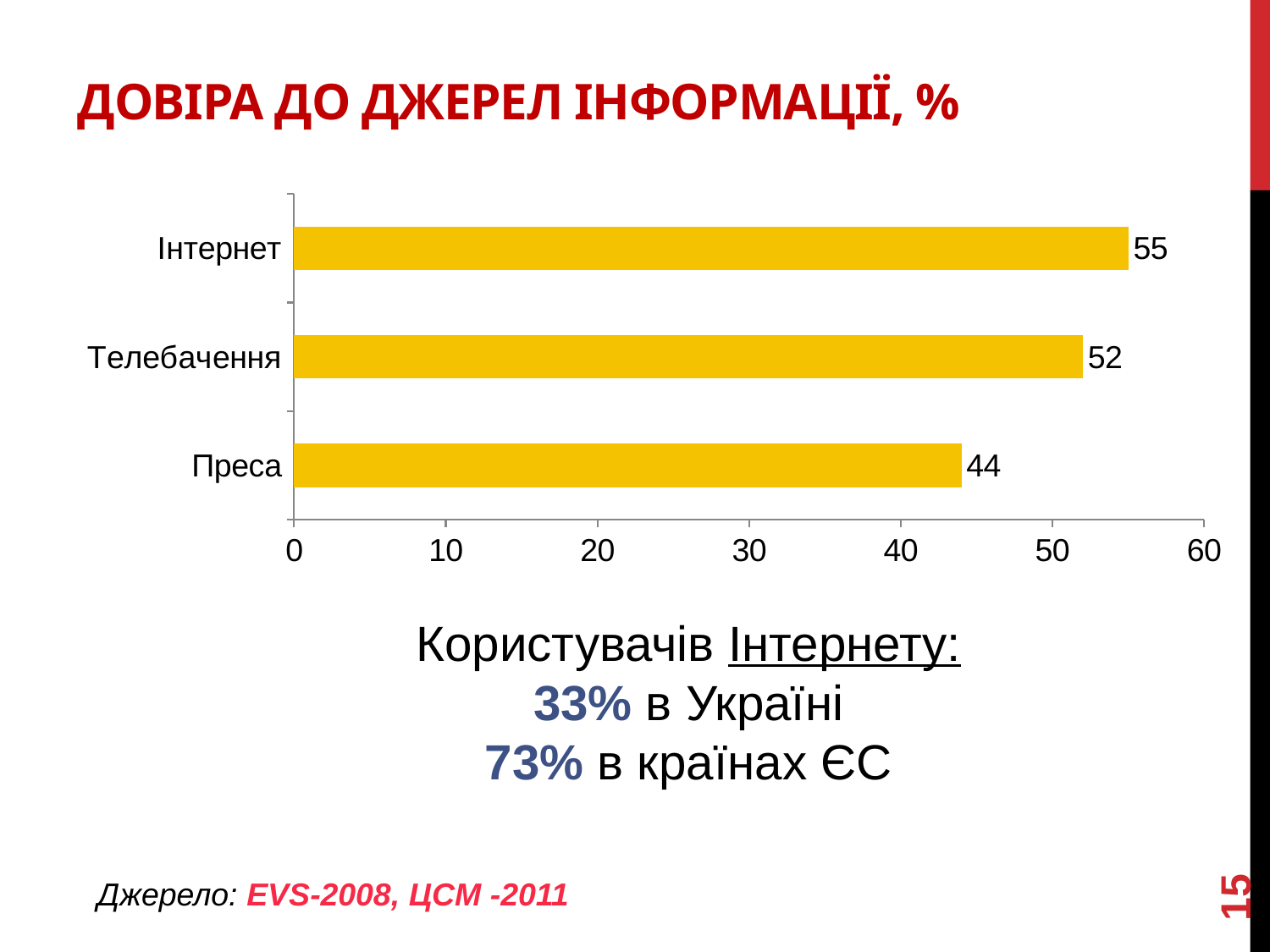
Is the value for Преса greater or less than 50? less Which category has the lowest value? Преса Which is larger, the value for Інтернет or the value for Преса? Інтернет What is the value for Преса? 44 What is the value for Інтернет? 55 What is the difference between the values for Телебачення and Преса? 8 Which category has the highest value? Інтернет How many categories are shown in the chart? 3 What is the difference between the values for Інтернет and Преса? 11 What kind of chart is shown on the slide? bar chart What is the value for Телебачення? 52 What is the title of the chart on the slide? ДОВІРА ДО ДЖЕРЕЛ ІНФОРМАЦІЇ, %